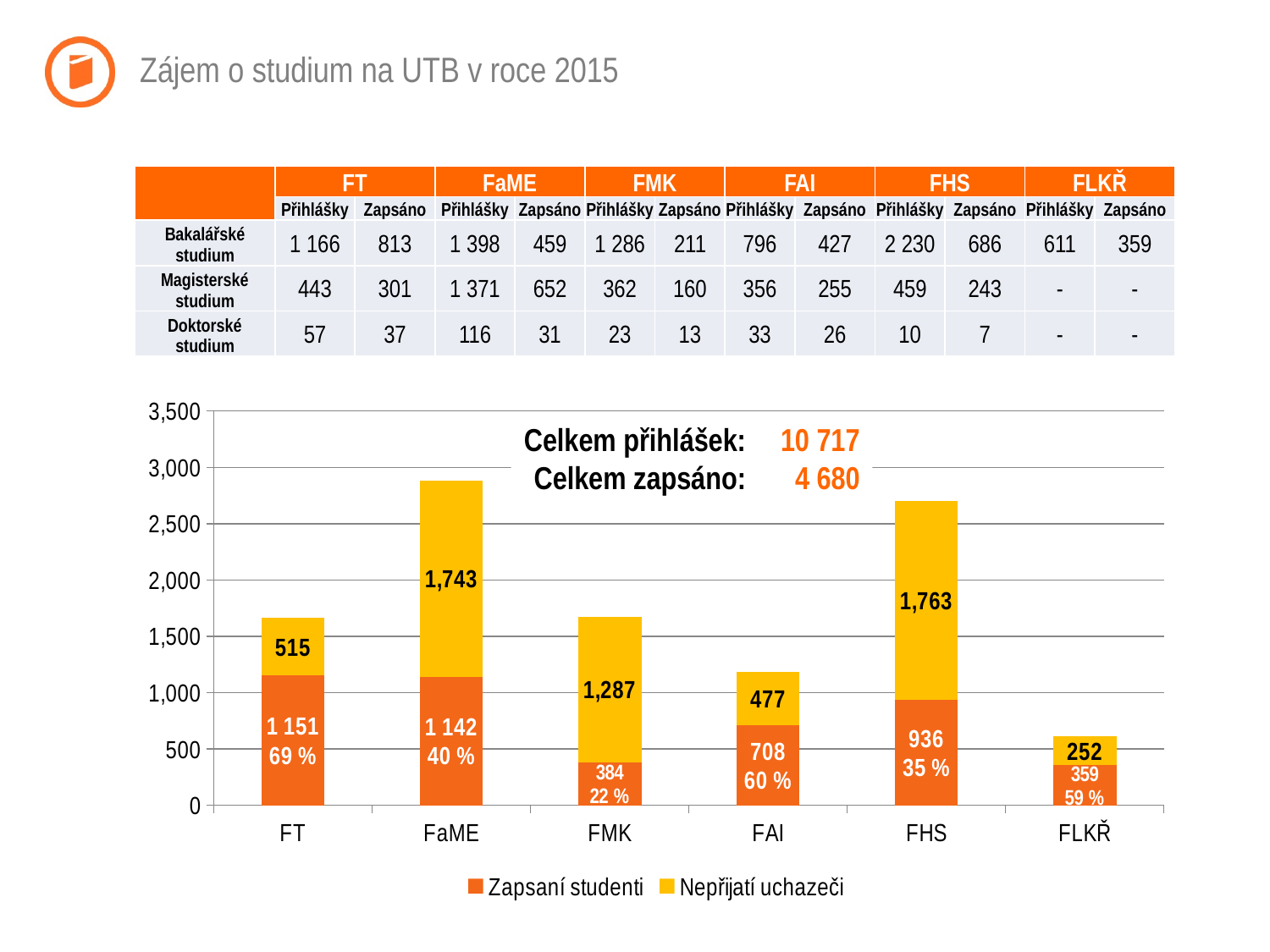
What type of chart is shown on the slide? bar chart What is the value of Zapsaní studenti for FHS? 936 Which faculty has the highest value for Nepřijatí uchazeči? FHS What is the value of Nepřijatí uchazeči for FaME? 1,743 Which faculty has the lowest value for Zapsaní studenti? FLKŘ What total number of applications (Celkem přihlášek) is printed on the chart? 10 717 How many series does the chart legend list? 2 What is the total height of the stacked bar for FLKŘ? 611 How many faculties are shown on the x axis of the chart? 6 What percentage is shown for Zapsaní studenti at FMK? 22 % Which is larger: Zapsaní studenti for FT or for FAI? FT What is the difference between Nepřijatí uchazeči for FHS and for FAI? 1,286